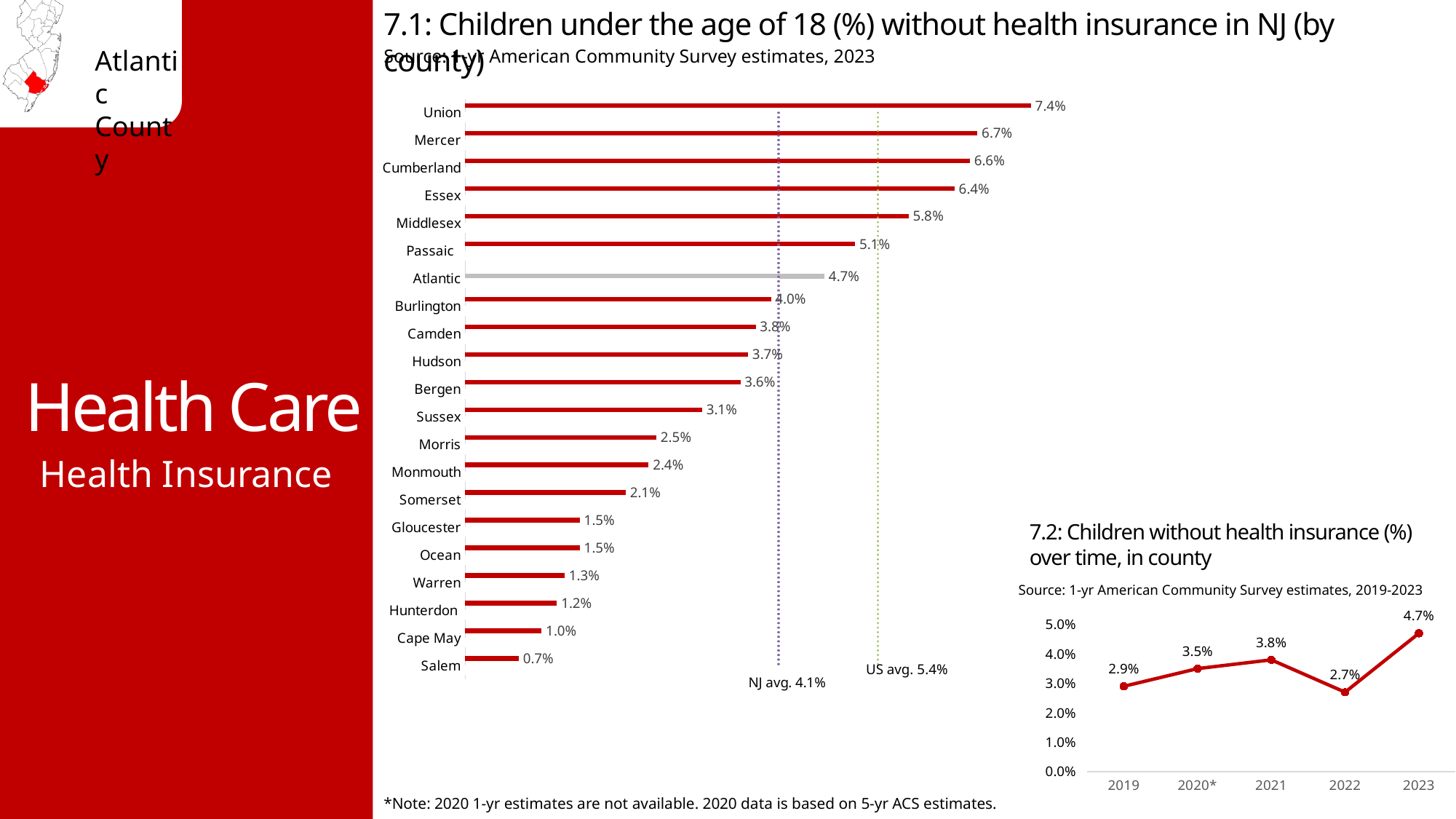
In chart 7.1, what is the value for Atlantic county? 4.7% In chart 7.1, which county has the lowest percentage of children without health insurance? Salem What type of chart is chart 7.2? line chart In chart 7.1, what NJ average is marked by the dotted reference line? 4.1% In chart 7.1, what is the value for Passaic? 5.1% In chart 7.2, what is the value for 2022? 2.7% In chart 7.1, what is the difference between the values for Union and Salem? 6.7% In chart 7.1, which county has the highest percentage of children without health insurance? Union In chart 7.1, how many counties are shown? 21 In chart 7.1, which county has a larger value, Essex or Middlesex? Essex In chart 7.2, which year has the highest value? 2023 In chart 7.2, what is the difference between the values for 2023 and 2019? 1.8%